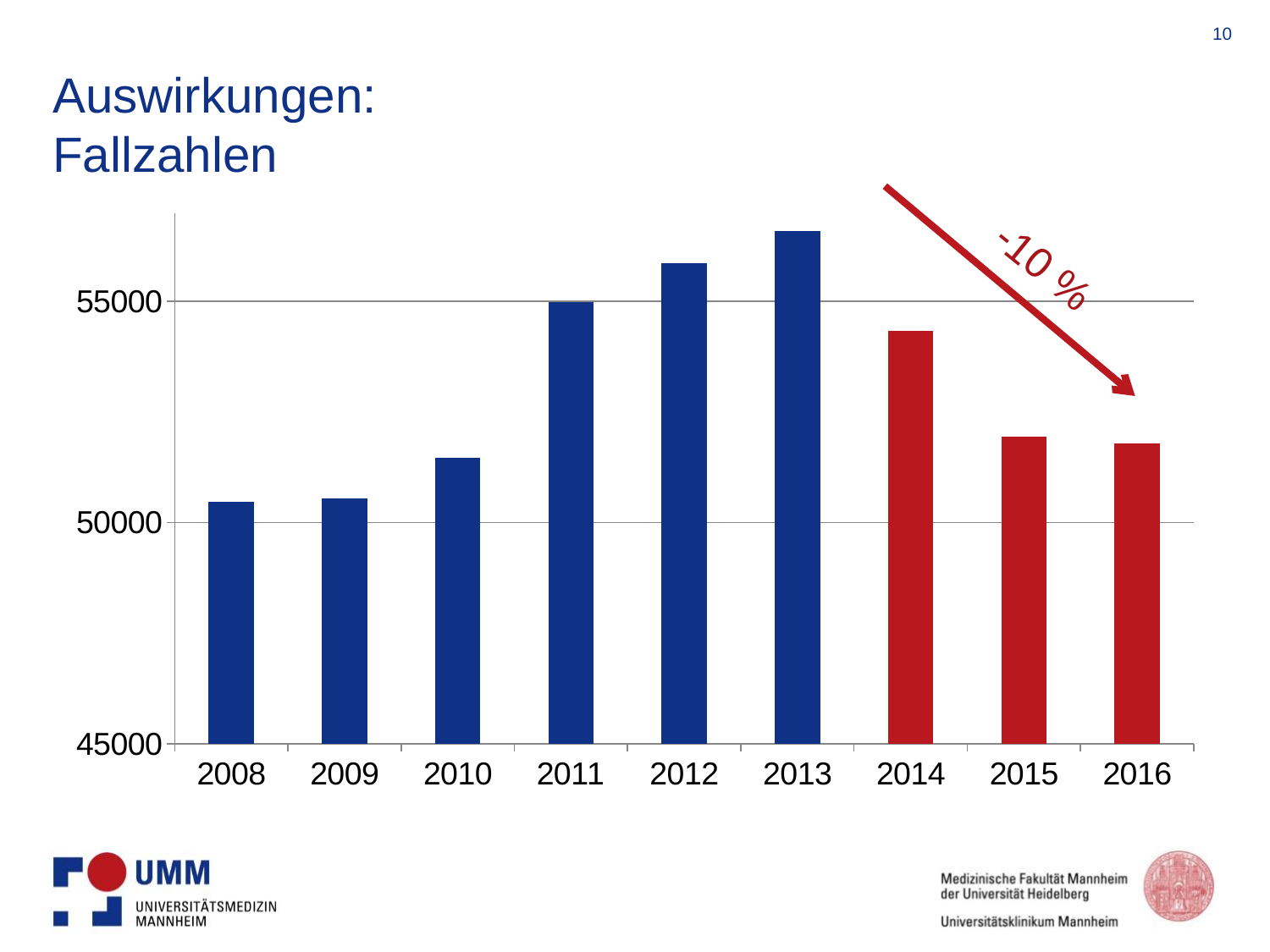
Is the value for 2008 greater or less than 50000? greater Is the value for 2014 greater or less than 55000? less Is the value for 2010 greater or less than 55000? less Which years are shown with red bars in the chart? 2014, 2015, 2016 Which year has the larger value, 2013 or 2014? 2013 What percentage change is written next to the arrow on the chart? -10 % What kind of chart is shown on the slide? bar chart Which year has the highest bar in the chart? 2013 Do the values rise or fall from 2013 to 2016? fall How many years are shown on the x axis of the chart? 9 Which year has the larger value, 2010 or 2011? 2011